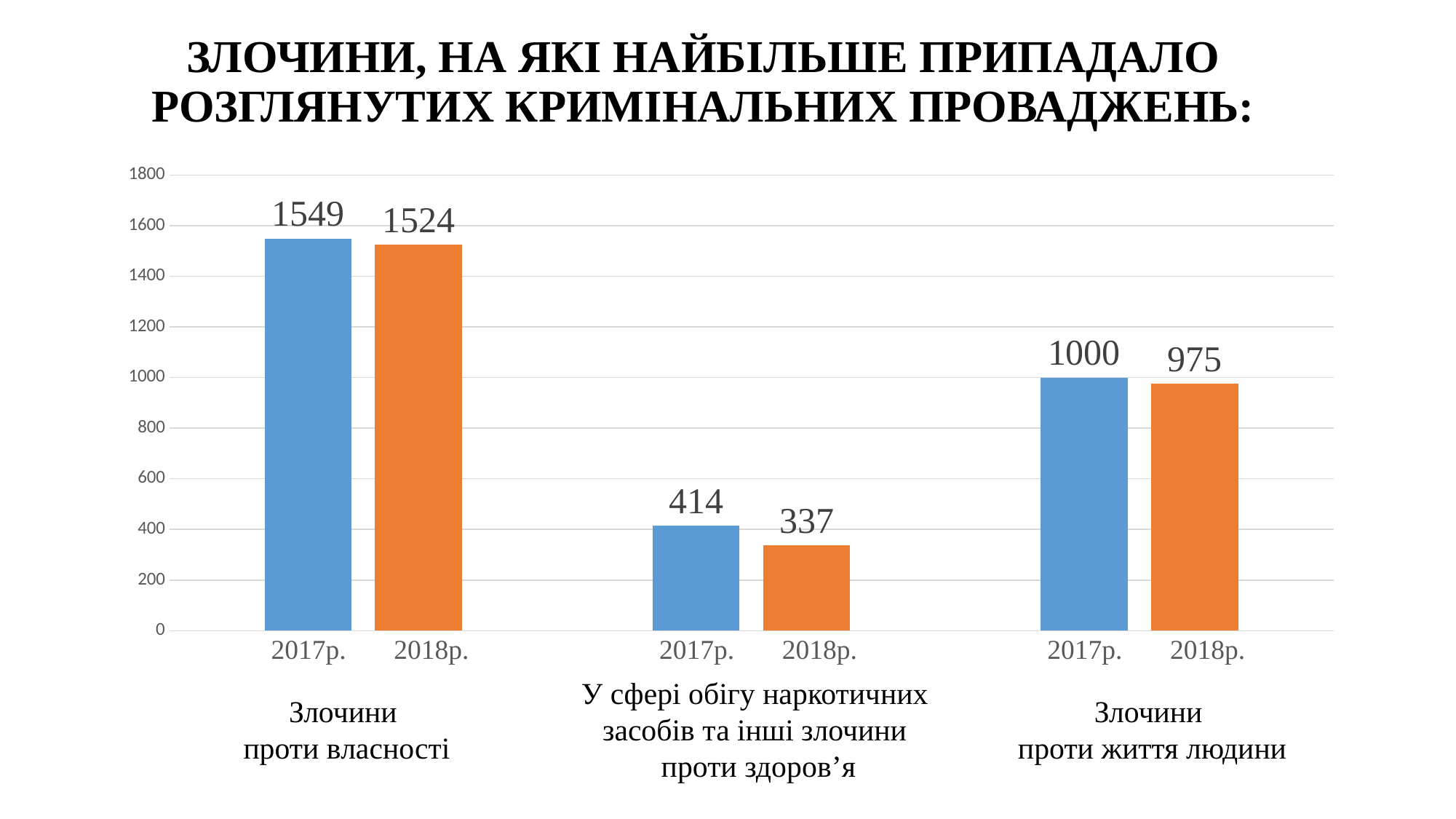
How many bars are plotted on the chart in total? 6 Within each group, does the value rise or fall from 2017р. to 2018р.? Fall Which bar has the highest value on the chart? 2017р., Злочини проти власності Which is larger: the 2017р. value for "Злочини проти життя людини" or the 2018р. value for "Злочини проти власності"? 2018р. value for Злочини проти власності What kind of chart is shown on the slide? Bar chart What is the difference between the 2017р. and 2018р. values in the "У сфері обігу наркотичних засобів та інші злочини проти здоров'я" group? 77 What is the value for 2018р. in the "Злочини проти власності" group? 1524 What is the difference between the 2017р. and 2018р. values in the "Злочини проти власності" group? 25 Which bar has the lowest value on the chart? 2018р., У сфері обігу наркотичних засобів та інші злочини проти здоров'я What is the value for 2017р. in the "Злочини проти власності" group? 1549 What is the value for 2017р. in the "У сфері обігу наркотичних засобів та інші злочини проти здоров'я" group? 414 What is the value for 2018р. in the "Злочини проти життя людини" group? 975